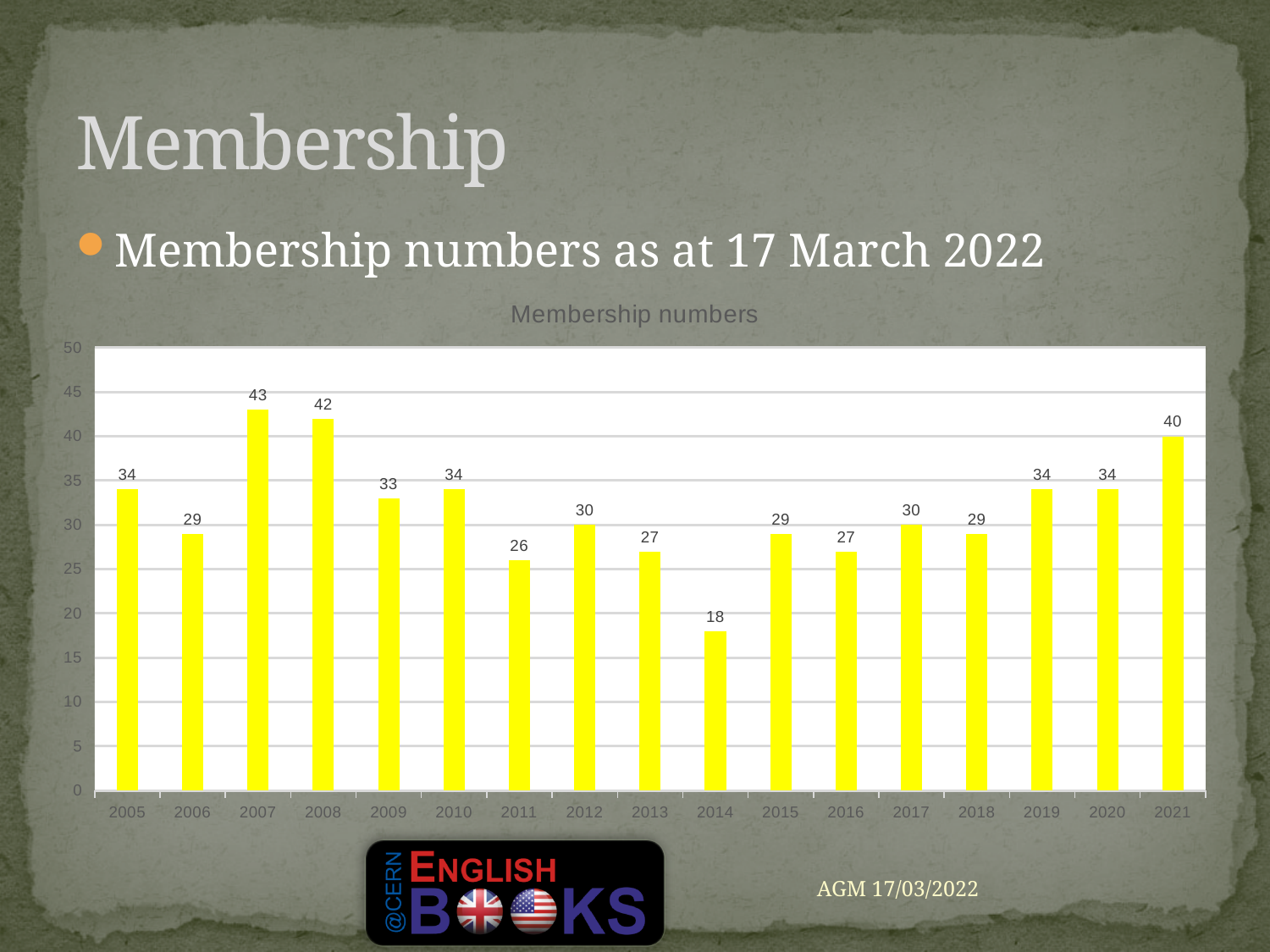
Which year has the lowest membership number? 2014 What is the membership number for 2007? 43 Is the membership number for 2011 greater or less than 30? less What is the difference between the membership numbers for 2007 and 2014? 25 Do the membership numbers rise or fall from 2018 to 2021? rise Which year has a larger membership number, 2008 or 2021? 2008 Which year has the highest membership number? 2007 What is the membership number for 2021? 40 What kind of chart is shown on the slide? bar chart What is the membership number for 2014? 18 How many years are shown on the x axis? 17 What is the title of the chart? Membership numbers